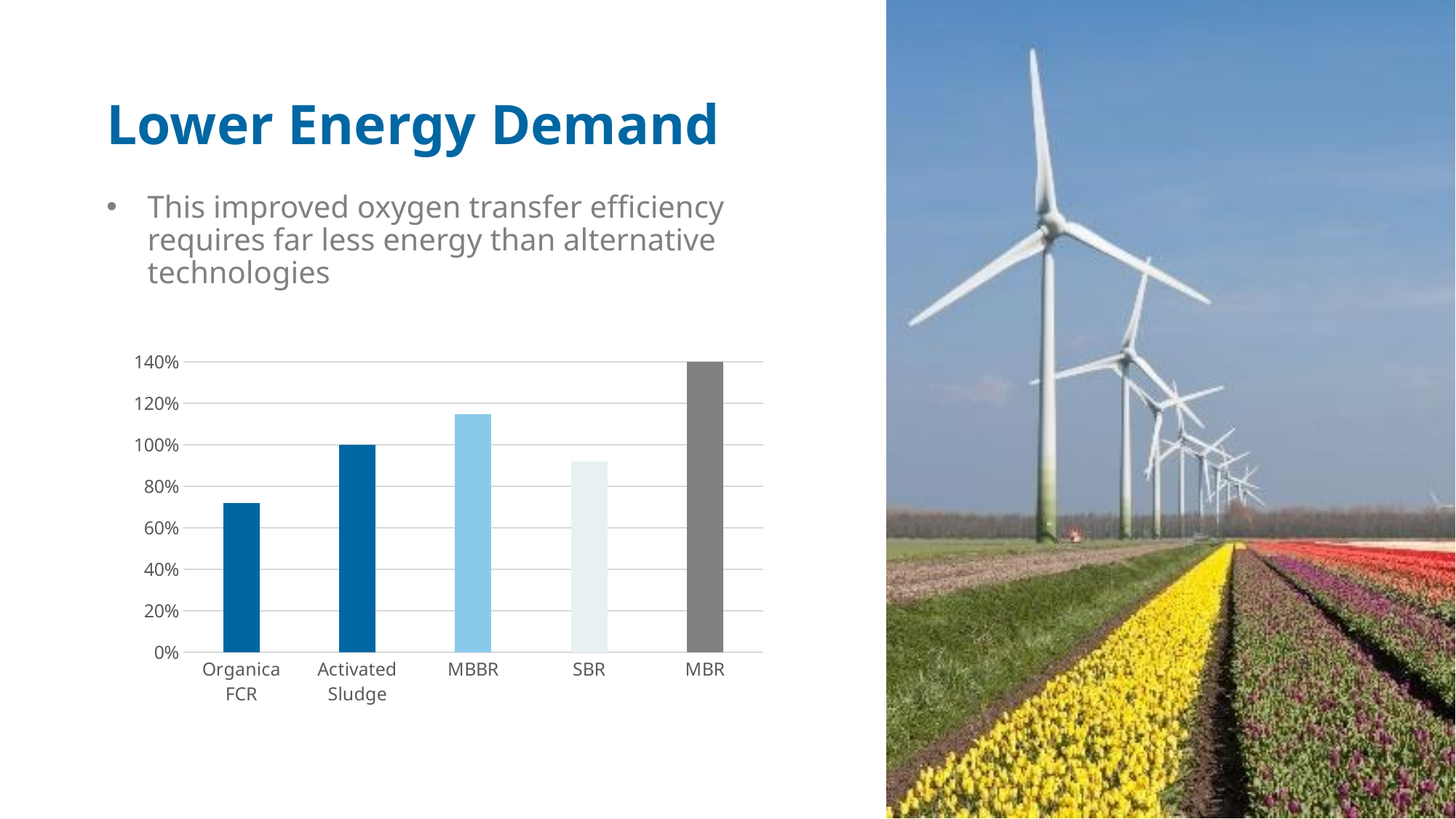
What is the title of the slide containing the chart? Lower Energy Demand What is the value for Activated Sludge? 100% Is the value for Organica FCR greater or less than 80%? less Is the value for SBR greater or less than 100%? less Is the value for MBBR greater or less than 100%? greater Which is larger, the value for MBBR or the value for SBR? MBBR How many categories are shown on the x axis of the chart? 5 What kind of chart is shown on the slide? bar chart Which category has the highest bar in the chart? MBR Which category has the lowest bar in the chart? Organica FCR Which is larger, the value for Organica FCR or the value for Activated Sludge? Activated Sludge What is the value for MBR? 140%